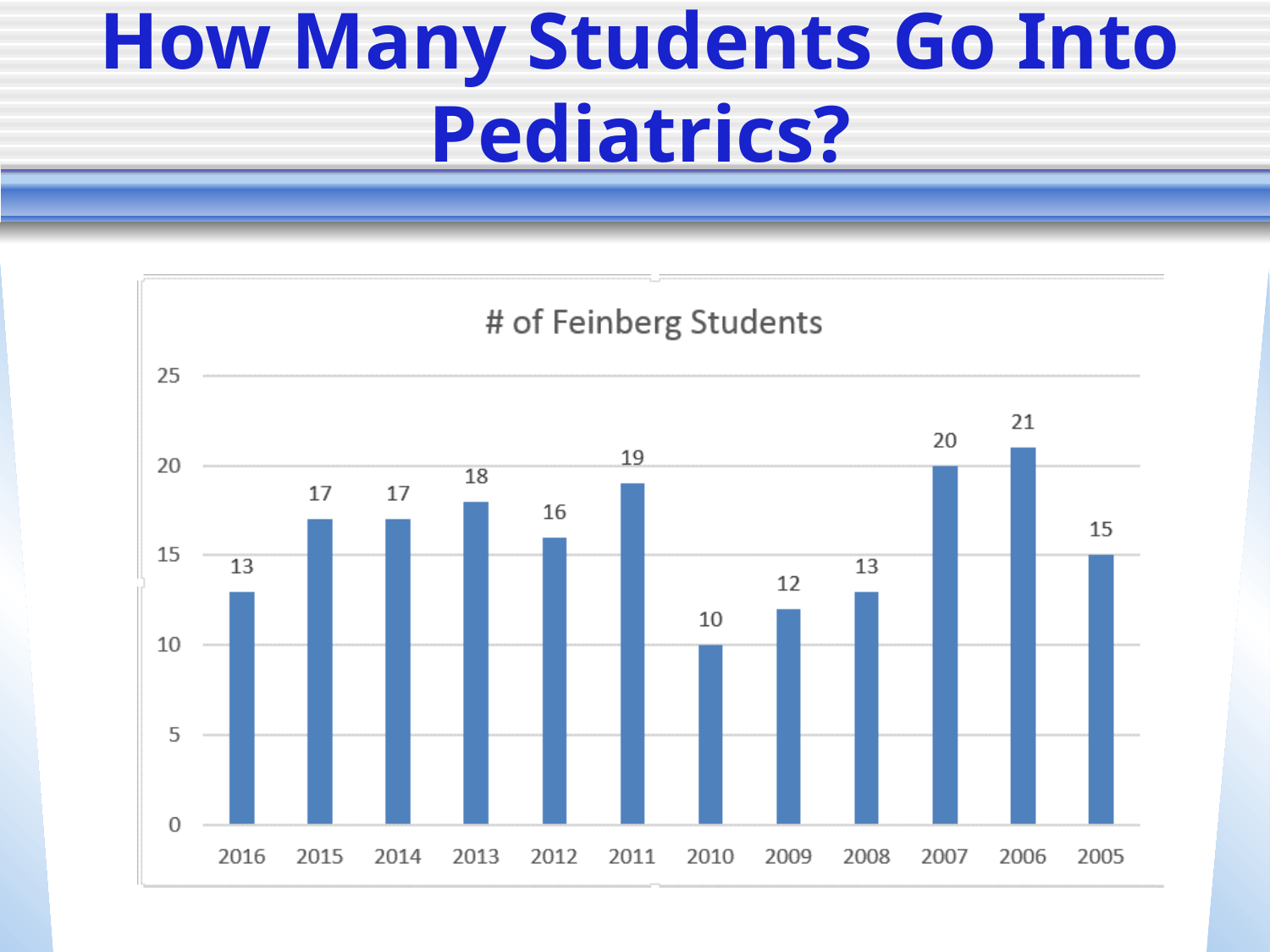
Which two years both have a value of 17? 2015 and 2014 What is the difference between the values for 2006 and 2016? 8 What is the value shown for 2010? 10 Which year has a larger value, 2011 or 2012? 2011 What kind of chart is shown on the slide? Bar chart Do the values rise or fall from 2010 to 2006 along the x axis? Rise Is the value for 2007 greater or less than 15? greater Which year has the lowest number of Feinberg students? 2010 What is the title of the chart? # of Feinberg Students Which year has the highest number of Feinberg students? 2006 How many years are shown on the x axis? 12 How many Feinberg students went into pediatrics in 2013? 18